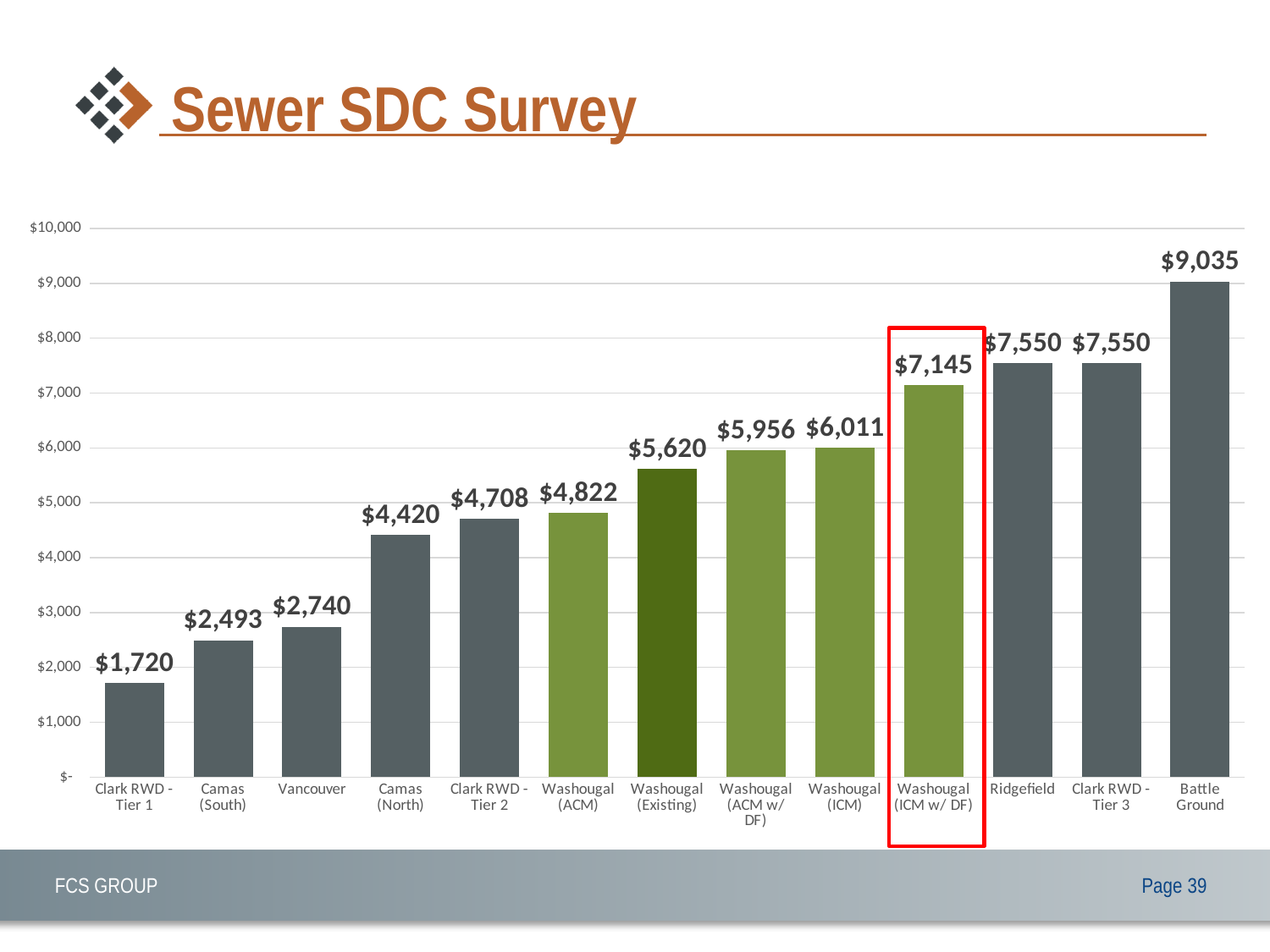
Which category has the highest value? Battle Ground Do the values rise or fall from left to right along the x axis? Rise What is the difference between Battle Ground and Washougal (ICM w/ DF)? $1,890 Which category has the lowest value? Clark RWD - Tier 1 Which is larger, Vancouver or Camas (South)? Vancouver What is the difference between Washougal (ICM w/ DF) and Washougal (Existing)? $1,525 What is the value for Camas (North)? $4,420 What is the value for Washougal (Existing)? $5,620 How many categories are shown on the chart? 13 Which category is highlighted with a red box? Washougal (ICM w/ DF) What is the value for Washougal (ICM w/ DF)? $7,145 What kind of chart is shown on the slide? Bar chart